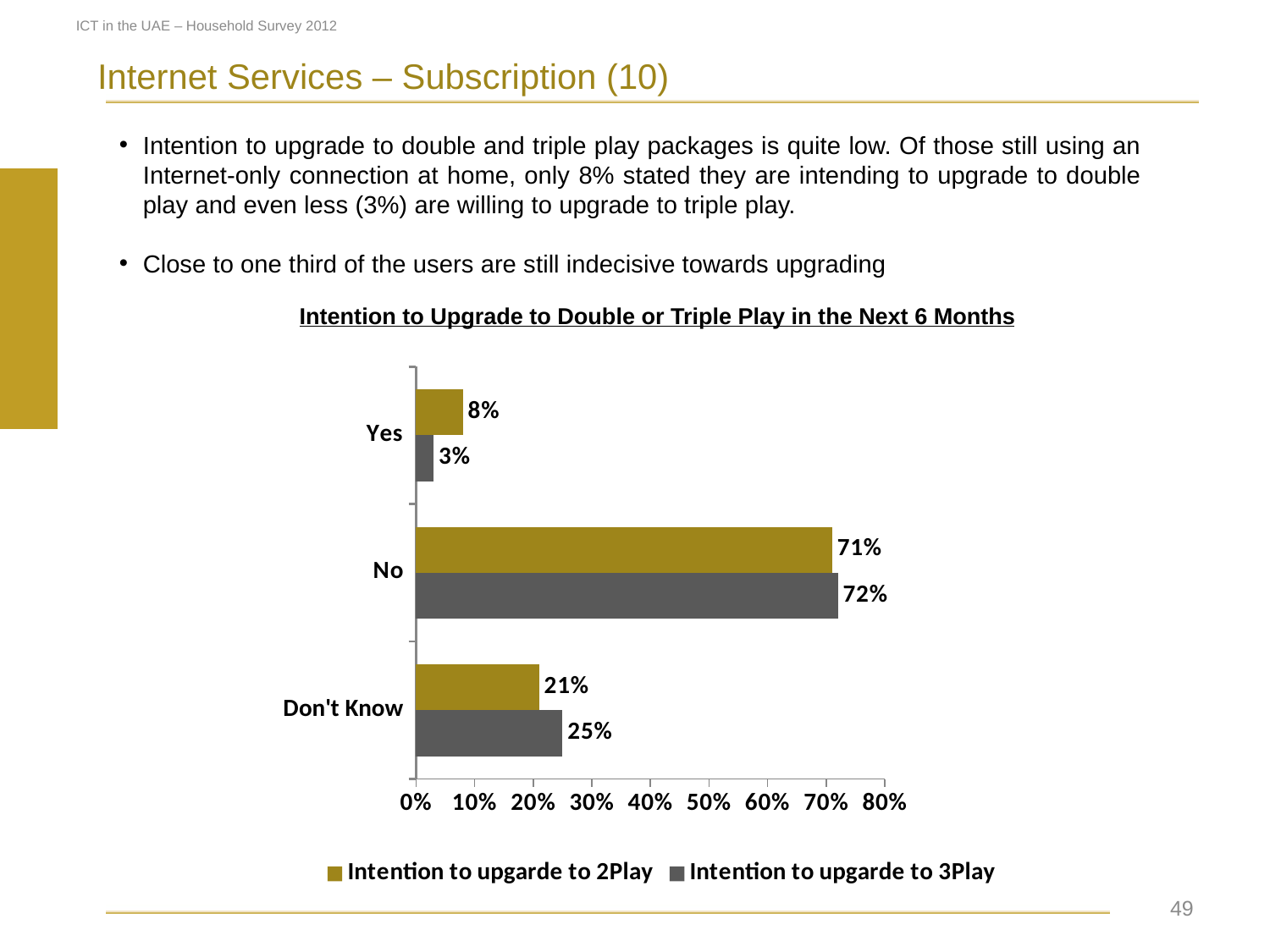
Is the value for "No" in the 3Play series greater or less than 70%? greater For "Yes", which series has the larger value: 2Play or 3Play? Intention to upgarde to 2Play Which category has the lowest value in the "Intention to upgarde to 3Play" series? Yes How many categories are shown on the chart? 3 What is the value for "Yes" in the "Intention to upgarde to 3Play" series? 3% What is the value for "Yes" in the "Intention to upgarde to 2Play" series? 8% How many series does the legend list? 2 What is the difference between the "Don't Know" values for the 3Play and 2Play series? 4% What kind of chart is shown on the slide? Bar chart Which category has the highest value in the "Intention to upgarde to 2Play" series? No What is the value for "Don't Know" in the "Intention to upgarde to 3Play" series? 25% What is the title of the chart? Intention to Upgrade to Double or Triple Play in the Next 6 Months